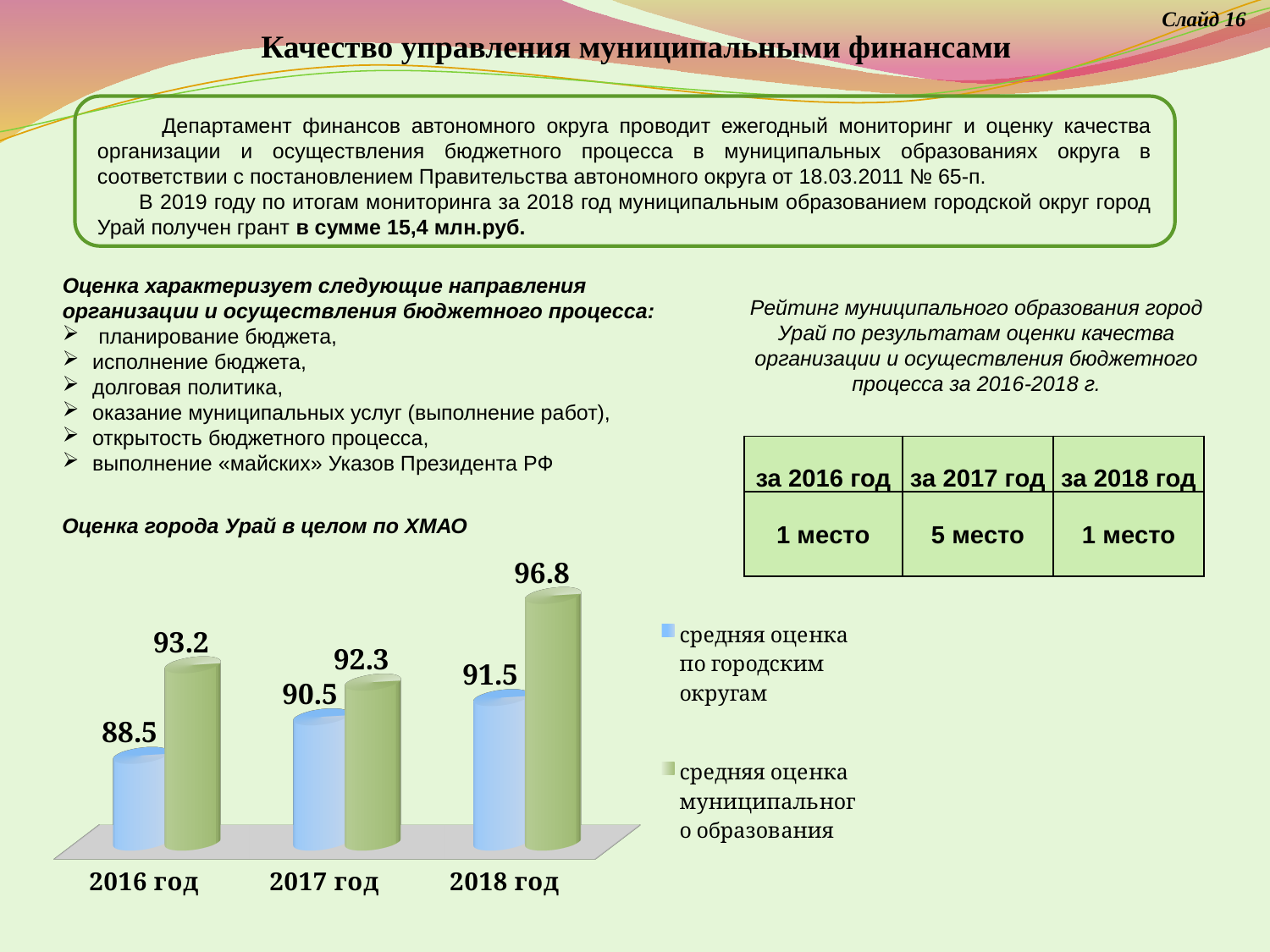
How many years (categories) are shown on the x axis of the chart? 3 What is the average score for urban districts (средняя оценка по городским округам) in 2016 год? 88.5 Which is larger in 2017 год: the average score for urban districts or the average score of the municipal entity? средняя оценка муниципального образования What is the title of the chart on the slide? Оценка города Урай в целом по ХМАО What is the average score of the municipal entity (средняя оценка муниципального образования) in 2018 год? 96.8 Does the average score for urban districts rise or fall from 2016 год to 2018 год? rise What kind of chart is shown on the slide? bar chart How many series does the chart legend list? 2 What is the difference between the municipal entity score and the urban districts score in 2018 год? 5.3 In which year is the average score for urban districts the lowest? 2016 год What is the average score of the municipal entity in 2017 год? 92.3 In which year is the average score of the municipal entity the highest? 2018 год